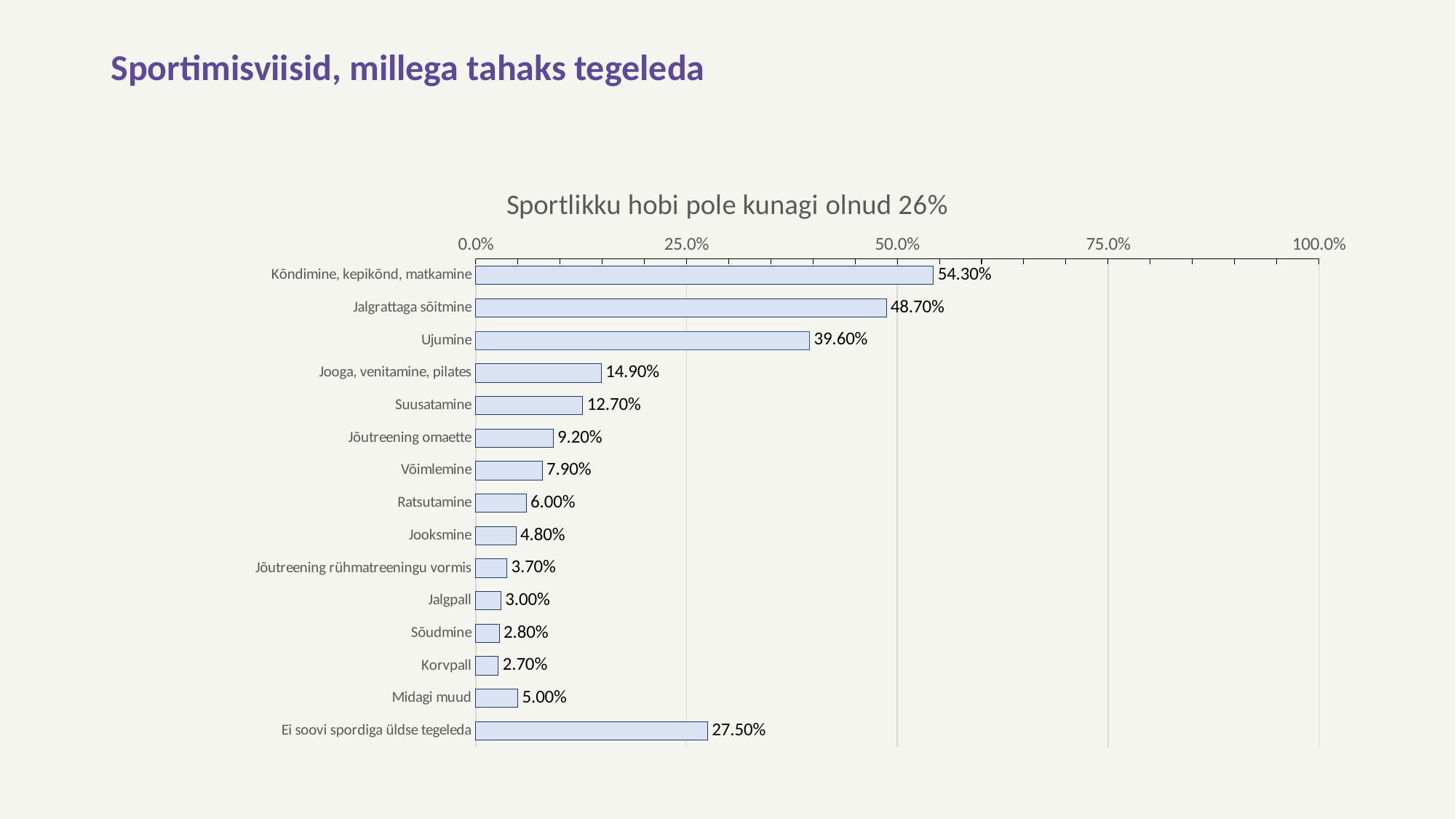
Is the value for Jalgrattaga sõitmine greater or less than 50.0%? less Which is larger, the value for Jooksmine or the value for Midagi muud? Midagi muud What is the value for Suusatamine? 12.70% What is the difference between the values for Jooga, venitamine, pilates and Suusatamine? 2.20% What kind of chart is shown on the slide? bar chart What is the title of the chart? Sportlikku hobi pole kunagi olnud 26% What is the difference between the values for Kõndimine, kepikõnd, matkamine and Jalgrattaga sõitmine? 5.60% What is the value for Ei soovi spordiga üldse tegeleda? 27.50% Which category has the lowest value? Korvpall How many categories are shown in the chart? 15 Which category has the highest value? Kõndimine, kepikõnd, matkamine What is the value for Ujumine? 39.60%